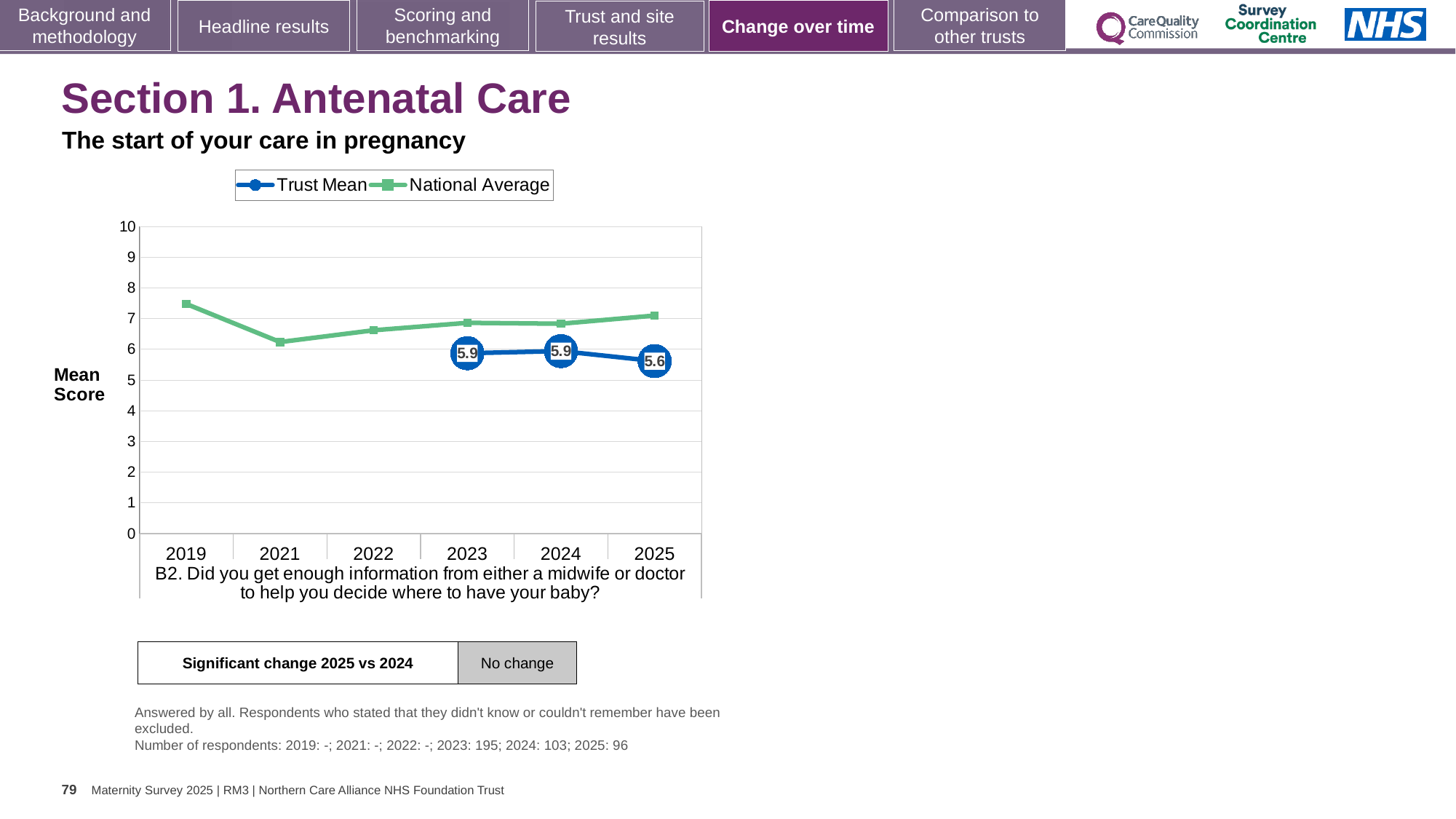
What kind of chart is shown on the slide? line chart What is the Trust Mean value for 2023? 5.9 What is the label on the y axis of the chart? Mean Score Is the National Average value for 2019 greater or less than 7? greater How many years are shown on the x axis? 6 What is the difference between the Trust Mean in 2024 and in 2025? 0.3 What is the Trust Mean value for 2025? 5.6 Is the National Average value for 2021 greater or less than 7? less How many series does the legend list? 2 Does the Trust Mean rise or fall from 2024 to 2025? fall In which year is the Trust Mean lowest? 2025 In 2025, which is larger: the Trust Mean or the National Average? National Average